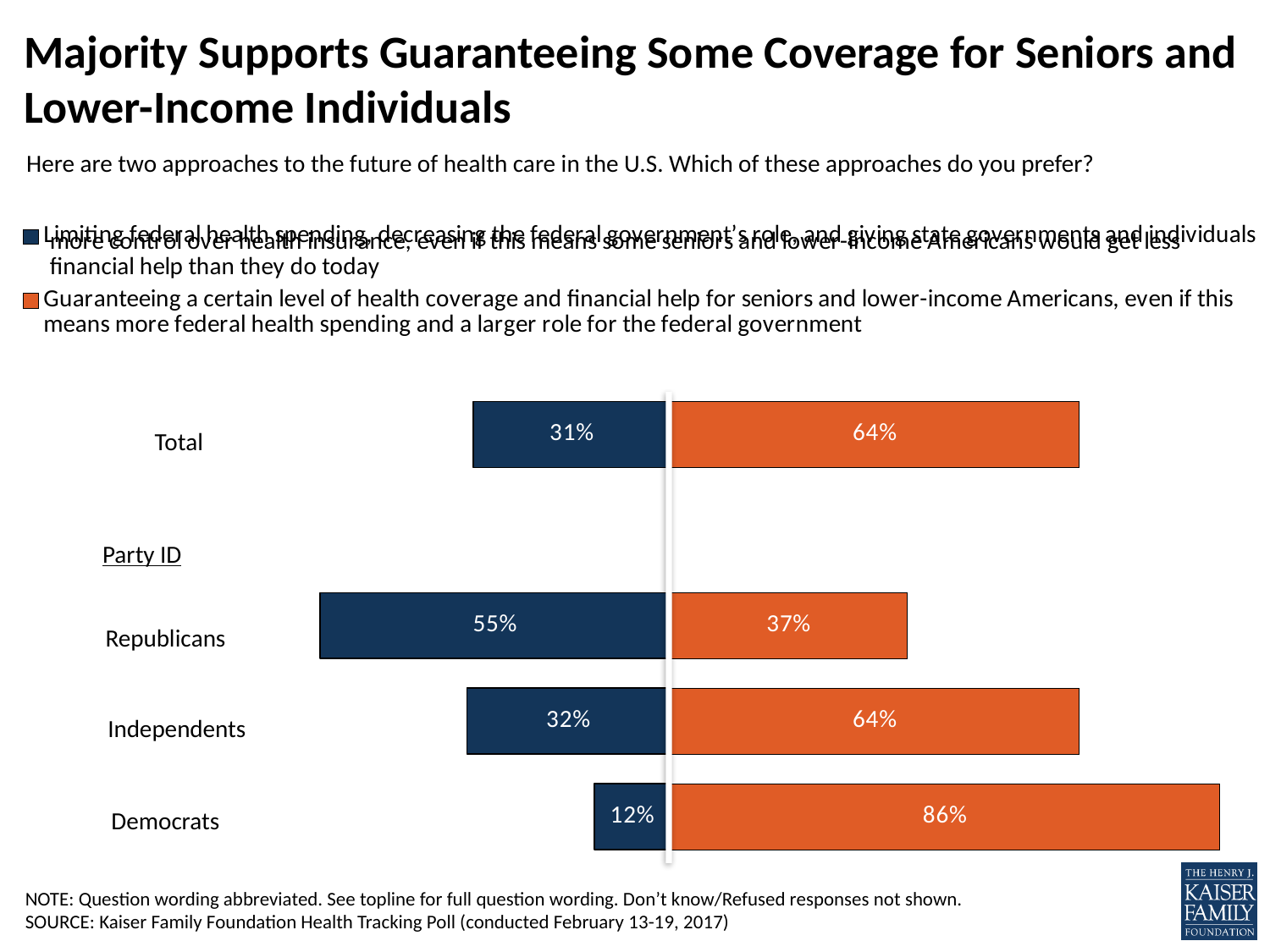
What colour represents the 'Guaranteeing a certain level of health coverage' series? Orange How many groups (bars) are shown in the chart? 4 What percentage of the Total group prefers guaranteeing a certain level of health coverage? 64% Which group has the highest share preferring guaranteeing a certain level of health coverage? Democrats Among Republicans, which approach is preferred by a larger share: limiting federal health spending or guaranteeing a certain level of health coverage? Limiting federal health spending What percentage of Independents prefer limiting federal health spending? 32% Which group has the lowest share preferring limiting federal health spending? Democrats What percentage of Democrats prefer guaranteeing a certain level of health coverage and financial help for seniors and lower-income Americans? 86% What is the difference between the share of Democrats and the share of Republicans who prefer guaranteeing a certain level of health coverage? 49 percentage points How many series does the legend list? 2 What kind of chart is shown on the slide? Bar chart What percentage of Republicans prefer limiting federal health spending and decreasing the federal government's role? 55%